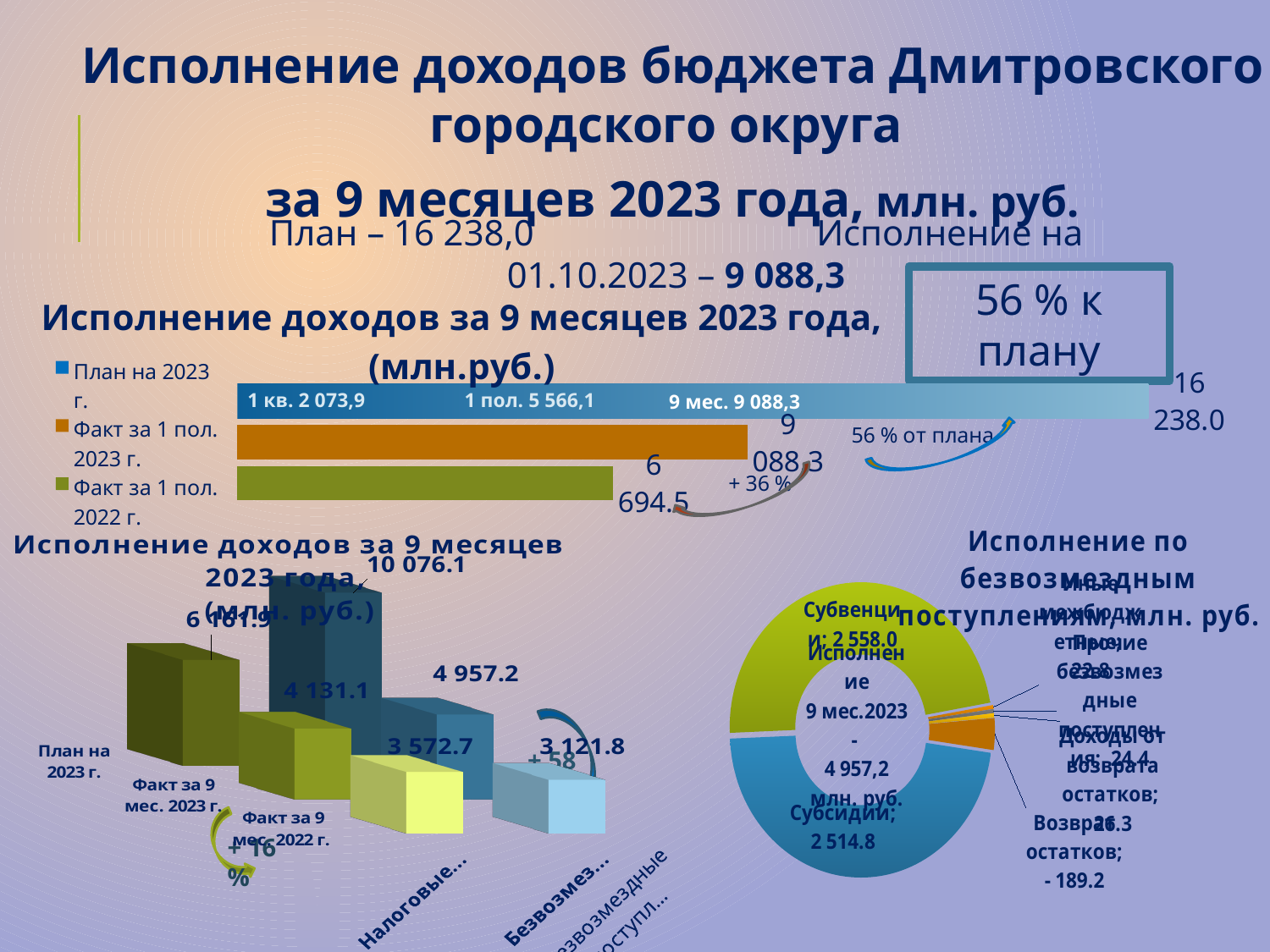
In the doughnut chart 'Исполнение по безвозмездным поступлениям', what is the difference between 'Субвенции' and 'Субсидии'? 43.2 In the top bar chart, which series has the lowest value? Факт за 1 пол. 2022 г. In the top bar chart, which series has the highest value? План на 2023 г. In the top bar chart, which is larger: 'Факт за 1 пол. 2023 г.' or 'Факт за 1 пол. 2022 г.'? Факт за 1 пол. 2023 г. In the top bar chart, what is the value for 'Факт за 1 пол. 2022 г.'? 6 694,5 How many series does the legend of the top bar chart list? 3 In the doughnut chart 'Исполнение по безвозмездным поступлениям', what is the value for 'Субсидии'? 2 514.8 In the top bar chart, what is the value for 'План на 2023 г.'? 16 238.0 What type of chart is the top chart titled 'Исполнение доходов за 9 месяцев 2023 года, (млн.руб.)'? Bar chart In the top bar chart, what is the value for 'Факт за 1 пол. 2023 г.'? 9 088,3 In the doughnut chart 'Исполнение по безвозмездным поступлениям', what is the value for 'Субвенции'? 2 558.0 In the bottom-left 3D bar chart 'Исполнение доходов за 9 месяцев 2023 года', what is the largest data label shown? 10 076.1